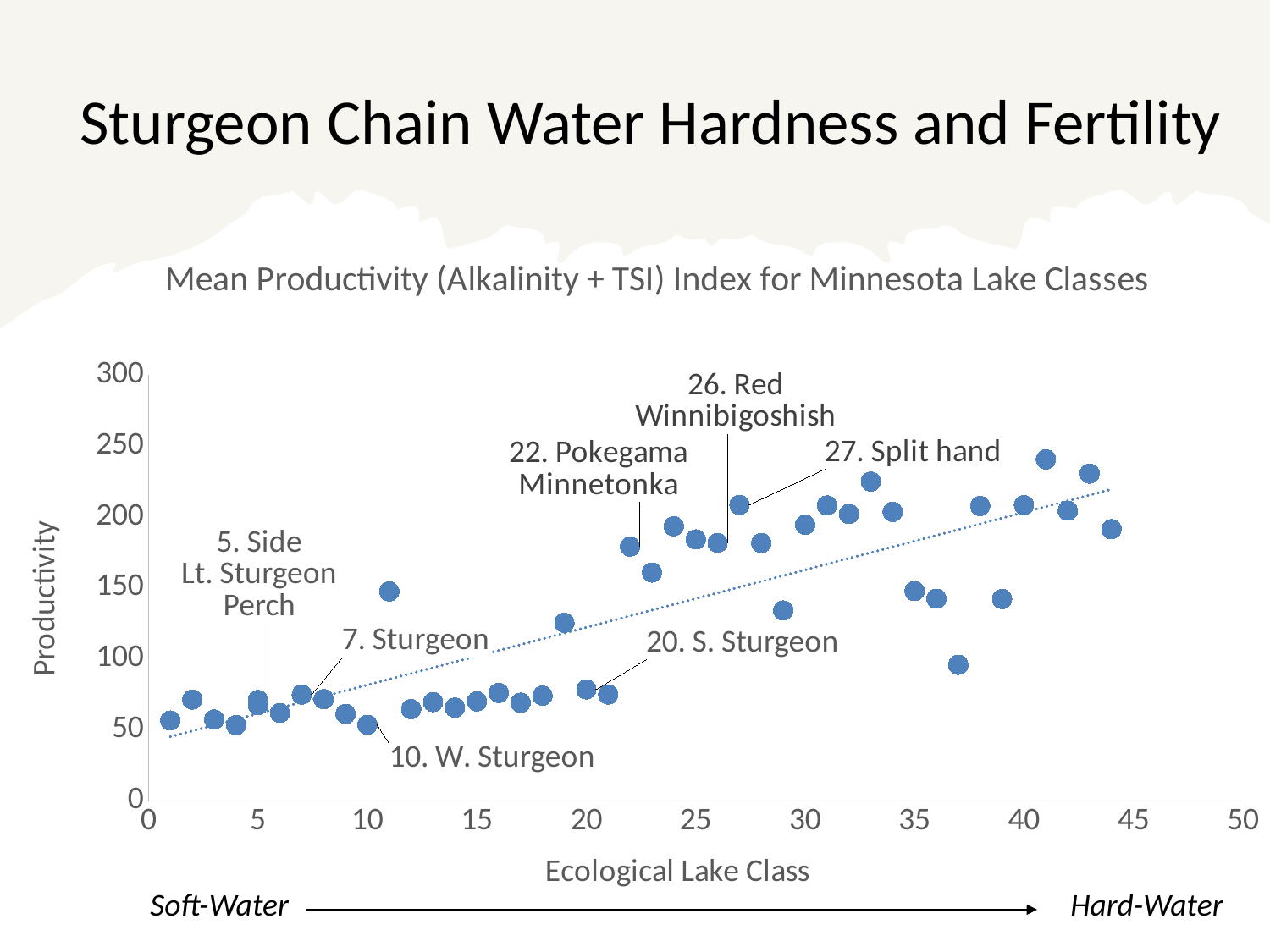
Which has the higher productivity value, the point labeled 22. Pokegama Minnetonka or the point labeled 10. W. Sturgeon? 22. Pokegama Minnetonka Which has the higher productivity value, the point labeled 7. Sturgeon or the point labeled 27. Split hand? 27. Split hand Is the productivity value for the point labeled 20. S. Sturgeon greater or less than 100? less Is the productivity value for the point labeled 26. Red Winnibigoshish greater or less than 150? greater What kind of chart is shown on the slide? scatter chart Is the productivity value for the point labeled 27. Split hand greater or less than 150? greater What is the label of the x axis? Ecological Lake Class Do productivity values generally rise or fall as the ecological lake class increases along the x axis? rise What is the title of the chart? Mean Productivity (Alkalinity + TSI) Index for Minnesota Lake Classes